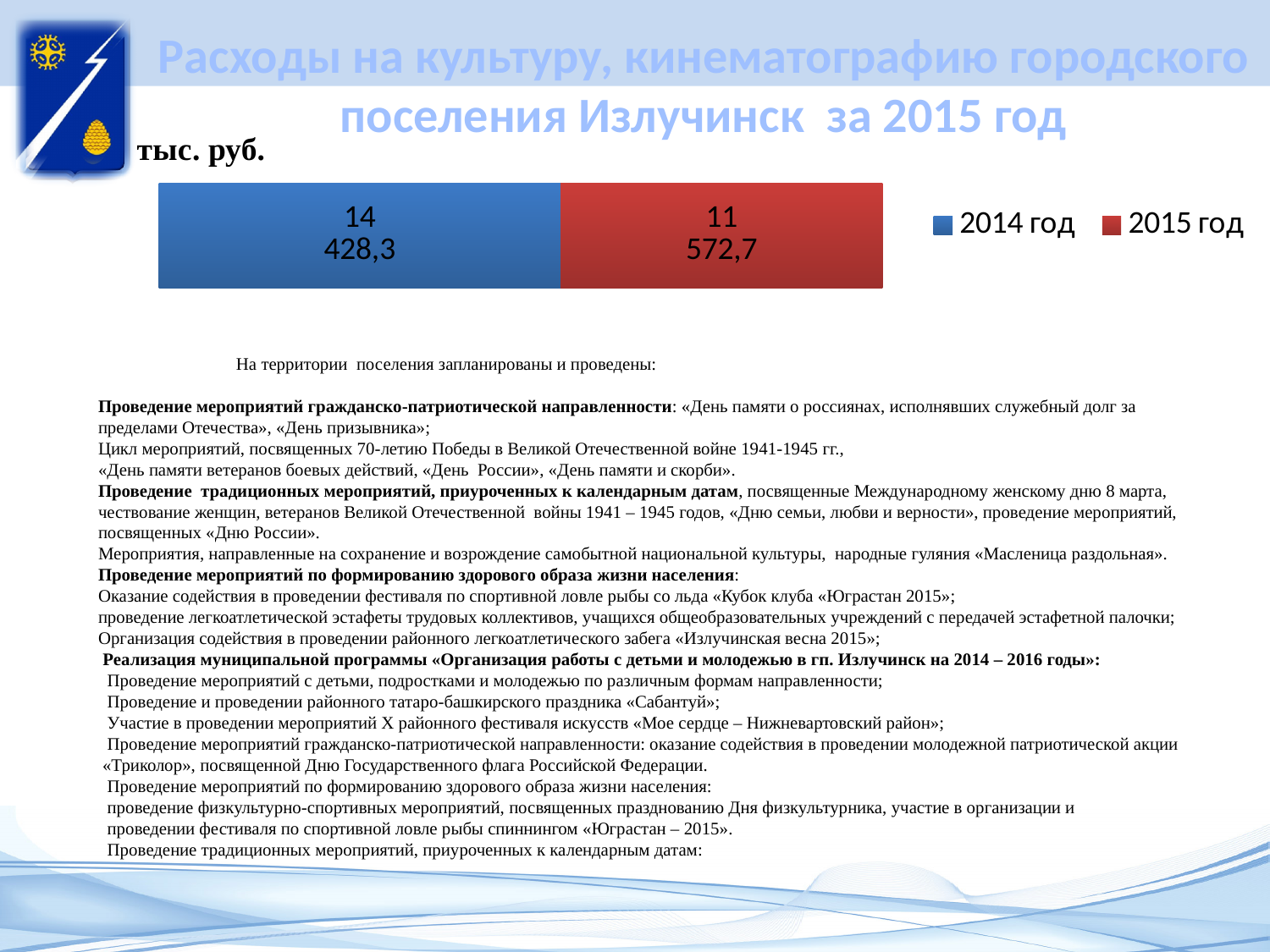
Which year has the higher value on the chart, 2014 год or 2015 год? 2014 год What unit is indicated for the chart values? тыс. руб. Which series has the highest value on the chart? 2014 год Which series has the lowest value on the chart? 2015 год What is the value for 2015 год on the chart? 11 572,7 What is the value for 2014 год on the chart? 14 428,3 What is the difference between the 2014 год and 2015 год values on the chart? 2 855,6 What colour represents 2015 год in the chart? Red What kind of chart is shown on the slide? Bar chart How many series does the legend list? 2 Did spending fall or rise from 2014 год to 2015 год according to the chart? Fall What is the total of the two segments in the stacked bar? 26 001,0